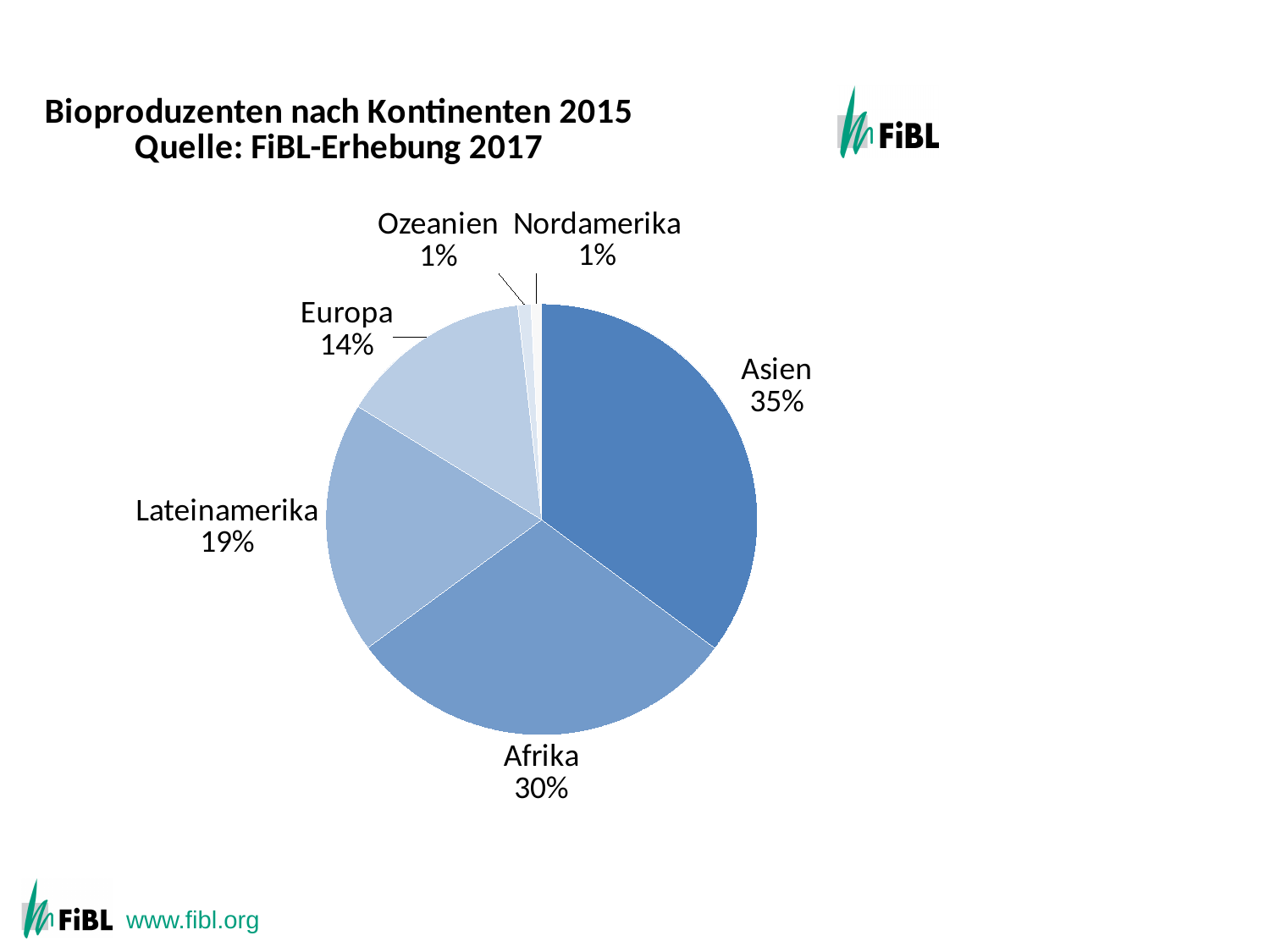
What is the value shown for Ozeanien? 1% What share of the pie does Asien have? 35% What is the title of the chart? Bioproduzenten nach Kontinenten 2015 Quelle: FiBL-Erhebung 2017 Which continent has the largest slice of the pie? Asien What is the value shown for Lateinamerika? 19% What is the difference in percentage points between Lateinamerika and Europa? 5 What is the difference in percentage points between Asien and Afrika? 5 Which is larger, the share for Afrika or the share for Lateinamerika? Afrika What is the value shown for Europa? 14% What kind of chart is shown on the slide? Pie chart What share of the pie does Afrika have? 30% How many continents are shown in the pie chart? 6